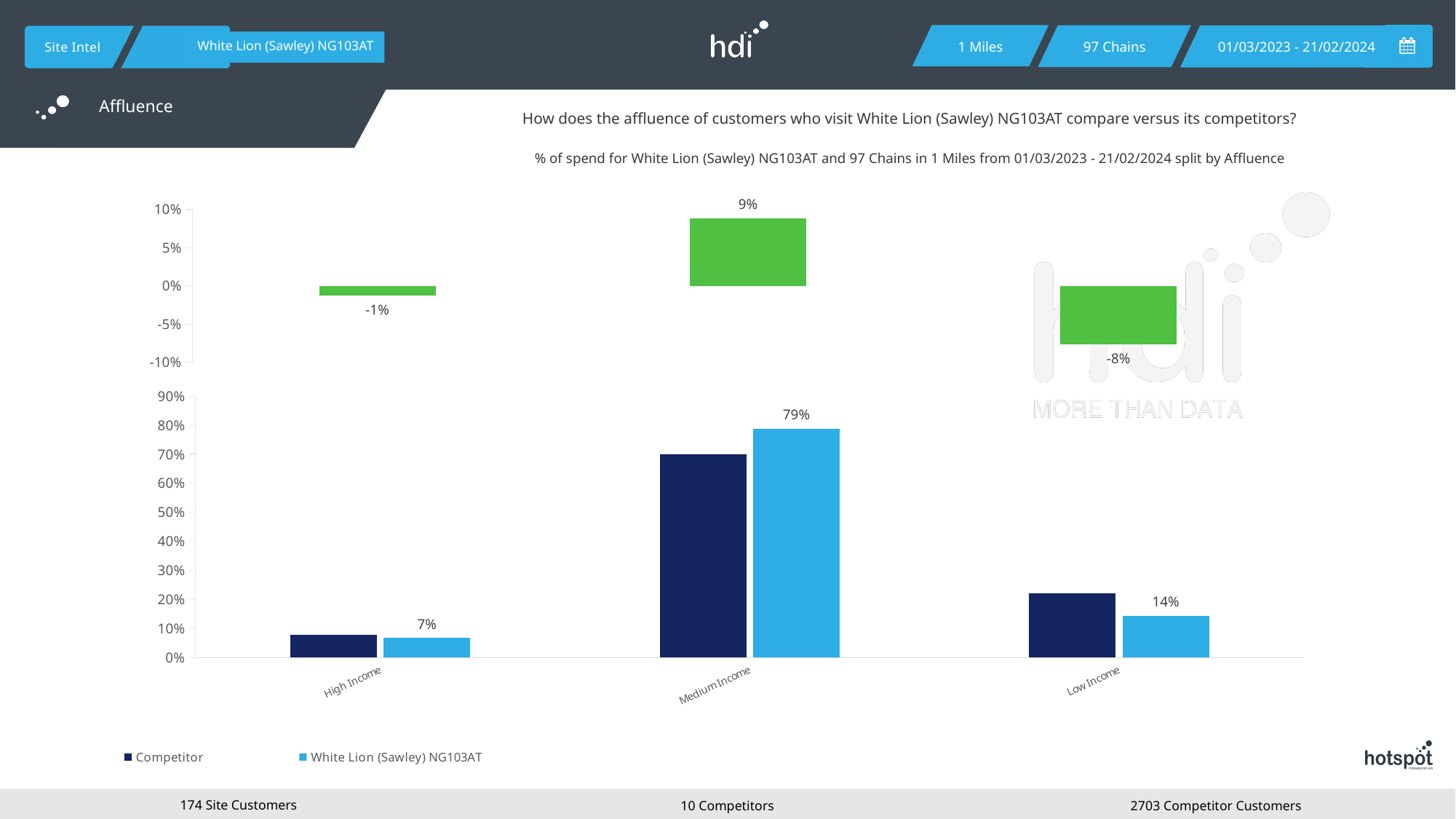
In the bottom bar chart, is the Competitor value for Medium Income greater or less than 60%? greater In the top chart with green bars, what is the value shown for Low Income? -8% How many series does the legend of the bottom bar chart list? 2 In the bottom bar chart, what is the value for White Lion (Sawley) NG103AT in the Medium Income category? 79% In the bottom bar chart, what is the difference between the White Lion (Sawley) NG103AT values for Medium Income and Low Income? 65% In the top chart with green bars, what is the value shown for Medium Income? 9% In the bottom bar chart, which category has the highest value for White Lion (Sawley) NG103AT? Medium Income In the bottom bar chart, what is the value for White Lion (Sawley) NG103AT in the High Income category? 7% In the bottom bar chart, which is larger for Low Income: the Competitor value or the White Lion (Sawley) NG103AT value? Competitor What type of chart is the bottom chart on the slide? Bar chart In the top chart with green bars, which category has the lowest value? Low Income In the bottom bar chart, what is the value for White Lion (Sawley) NG103AT in the Low Income category? 14%